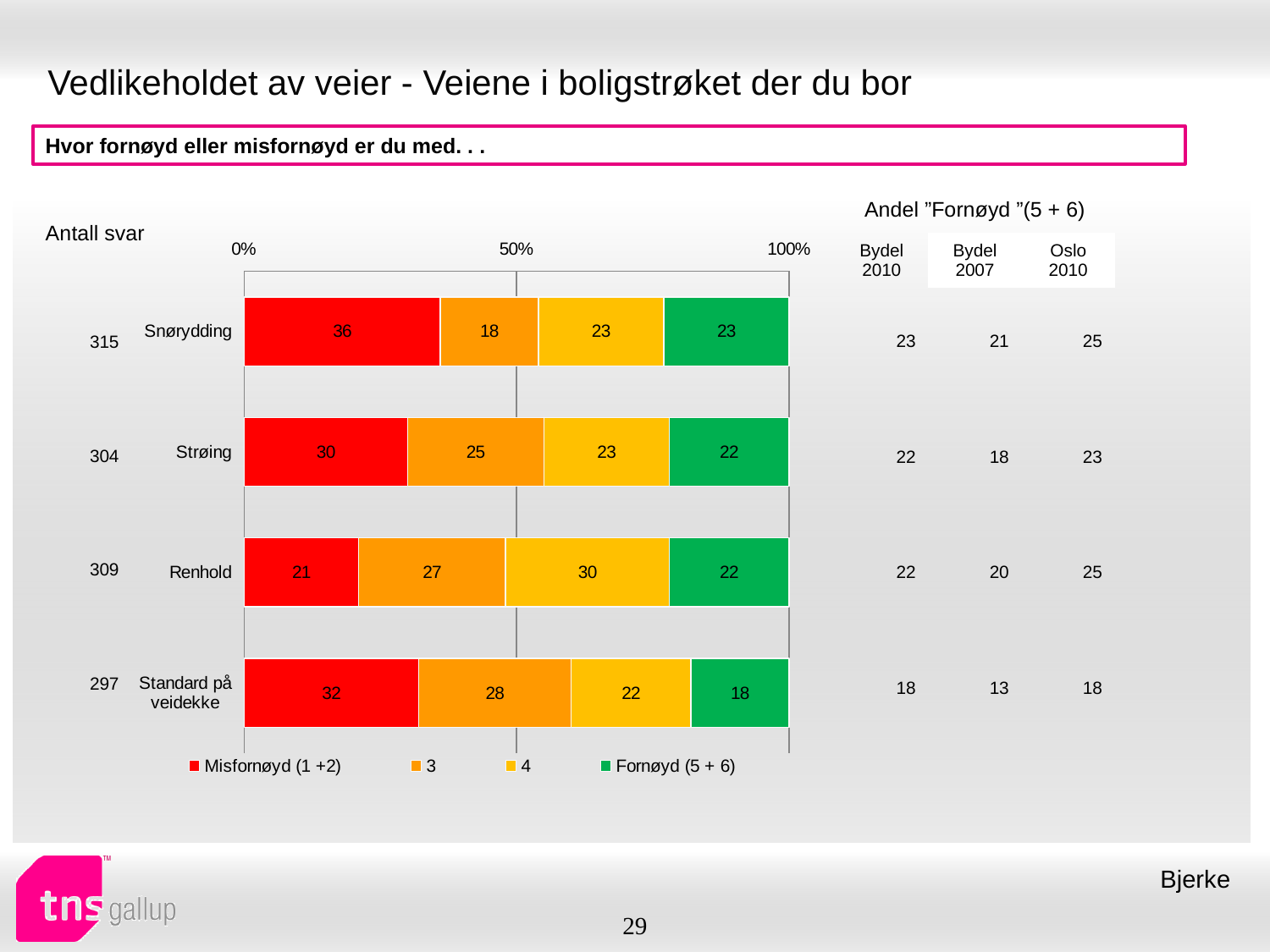
How many categories are shown in the chart? 4 Which category has the lowest Fornøyd (5 + 6) value? Standard på veidekke What is the difference between the Misfornøyd (1 +2) values for Snørydding and Renhold? 15 What is the Misfornøyd (1 +2) value for Snørydding? 36 What is the value of series 3 for Strøing? 25 Which category has the highest Misfornøyd (1 +2) value? Snørydding What is the Fornøyd (5 + 6) value for Standard på veidekke? 18 What kind of chart is shown on the slide? Stacked bar chart What is the value of series 4 for Renhold? 30 What is the total of the stacked bar for Strøing? 100 How many series does the legend list? 4 Which is larger: the series 3 value for Standard på veidekke or for Snørydding? Standard på veidekke